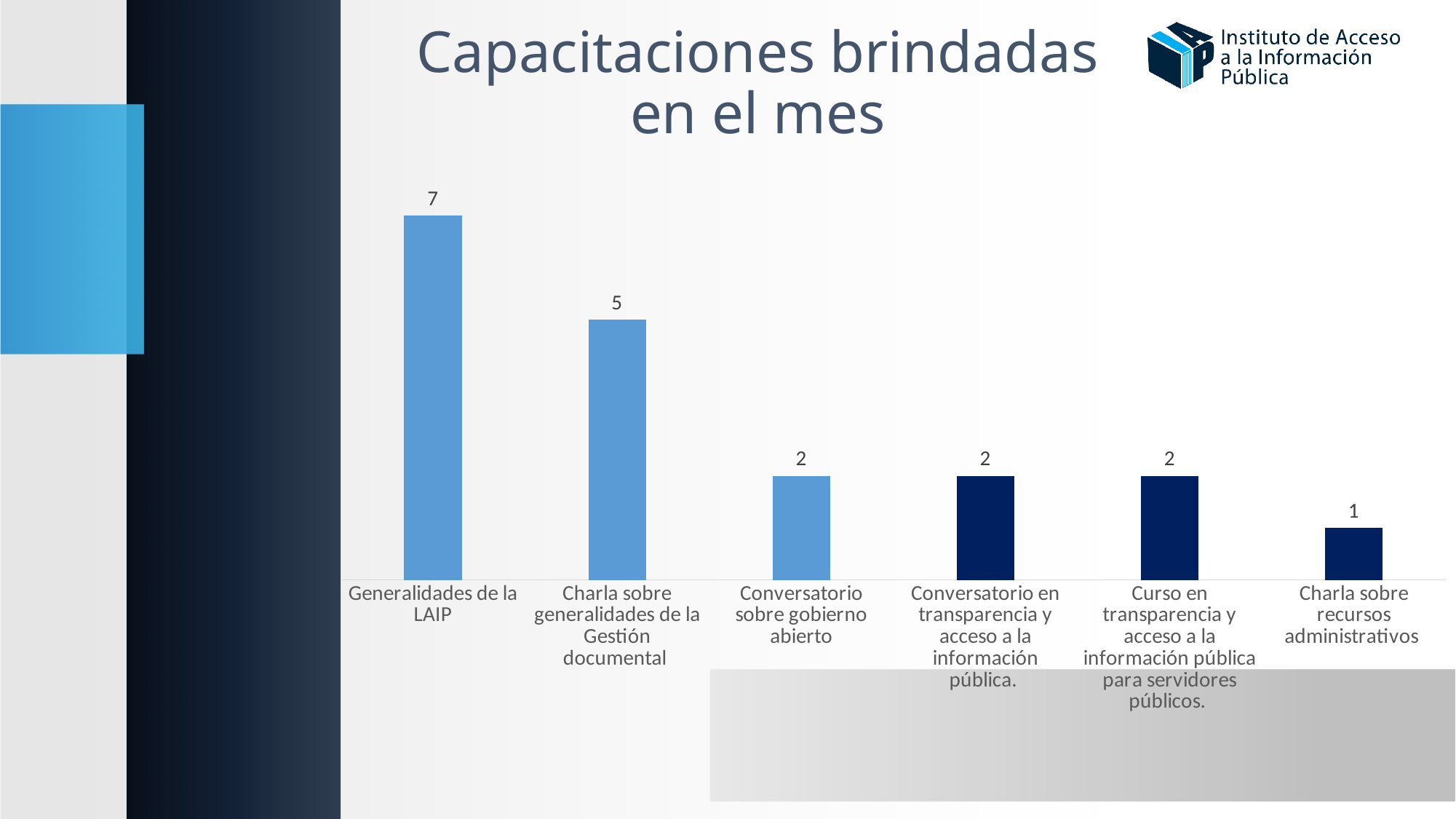
What is the value for Charla sobre recursos administrativos? 1 What kind of chart is shown on the slide? Bar chart Which category has the lowest value? Charla sobre recursos administrativos Which is larger, the value for Charla sobre generalidades de la Gestión documental or the value for Curso en transparencia y acceso a la información pública para servidores públicos? Charla sobre generalidades de la Gestión documental What is the value for Conversatorio sobre gobierno abierto? 2 What is the value for Charla sobre generalidades de la Gestión documental? 5 Which category has the highest value? Generalidades de la LAIP What is the value for Generalidades de la LAIP? 7 What is the title of the chart? Capacitaciones brindadas en el mes Do the values rise or fall from left to right across the categories? Fall How many categories are shown in the chart? 6 What is the difference between the values for Generalidades de la LAIP and Charla sobre generalidades de la Gestión documental? 2